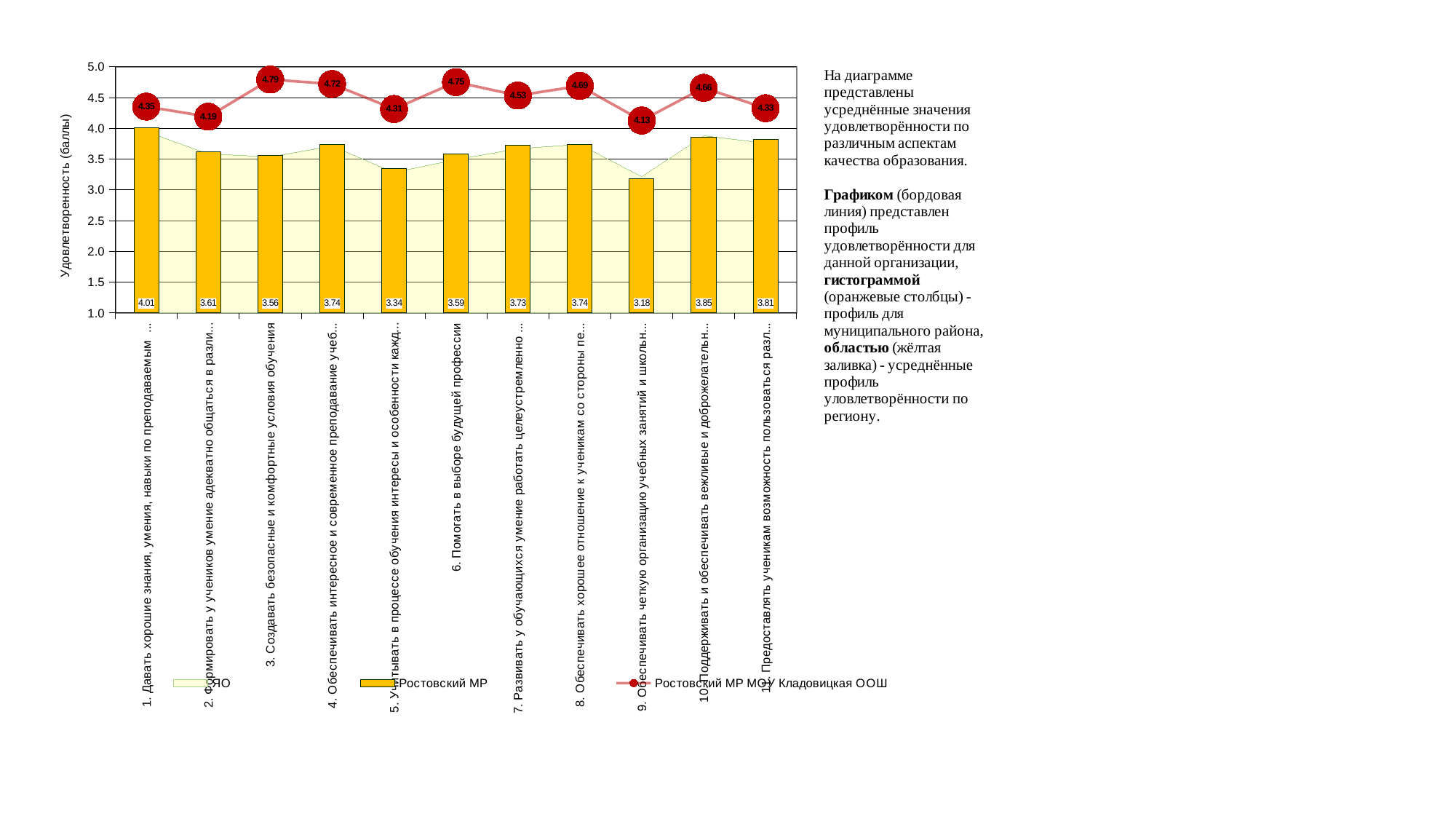
Which is larger, the Ростовский МР bar for category 10 or for category 11? Category 10 How many series does the legend list? 3 Which category has the lowest value on the Ростовский МР МОУ Кладовицкая ООШ line? Category 9 What is the value of the Ростовский МР bar for category 6, "Помогать в выборе будущей профессии"? 3.59 What is the value of the Ростовский МР МОУ Кладовицкая ООШ line for category 3, "Создавать безопасные и комфортные условия обучения"? 4.79 For category 6, "Помогать в выборе будущей профессии", how much higher is the Ростовский МР МОУ Кладовицкая ООШ line value than the Ростовский МР bar value? 1.16 How many categories are shown on the x axis? 11 What is the title of the vertical axis? Удовлетворенность (баллы) Which category has the highest value on the Ростовский МР МОУ Кладовицкая ООШ line? Category 3 (Создавать безопасные и комфортные условия обучения) What is the value of the Ростовский МР bar for category 9? 3.18 Which category has the highest Ростовский МР bar? Category 1 (Давать хорошие знания, умения, навыки по преподаваемым...) Which category has the lowest Ростовский МР bar? Category 9